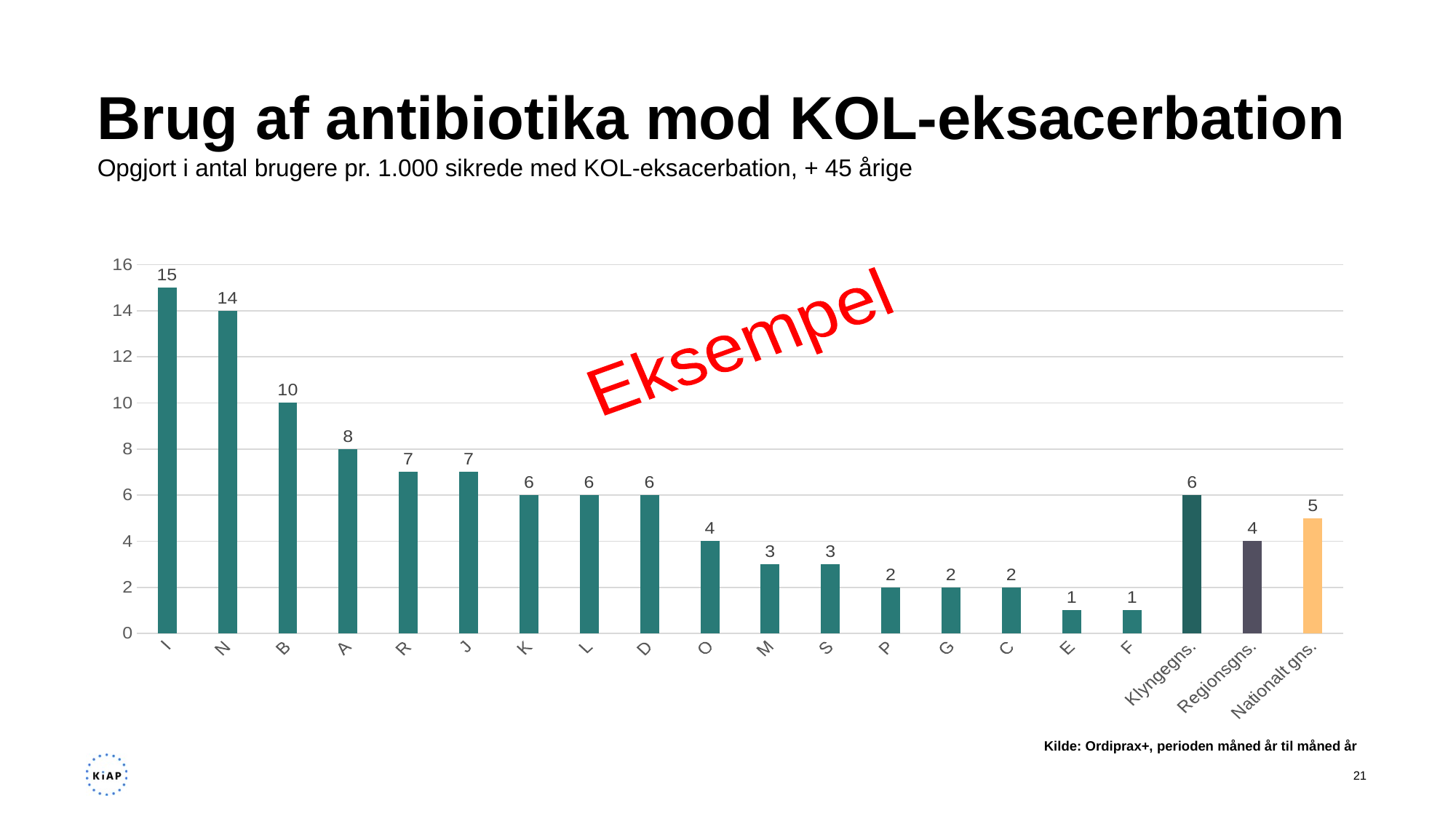
What is the difference between the values for B and Nationalt gns.? 5 What is the difference between the values for I and N? 1 What is the value for Klyngegns.? 6 What is the value for category I? 15 What is the value for Nationalt gns.? 5 What is the title of the slide? Brug af antibiotika mod KOL-eksacerbation What kind of chart is shown on the slide? bar chart What is the value for Regionsgns.? 4 Which is larger, the value for A or the value for O? A Which category has the highest value? I Is the value for B greater or less than 8? greater How many bars are shown in the chart? 20